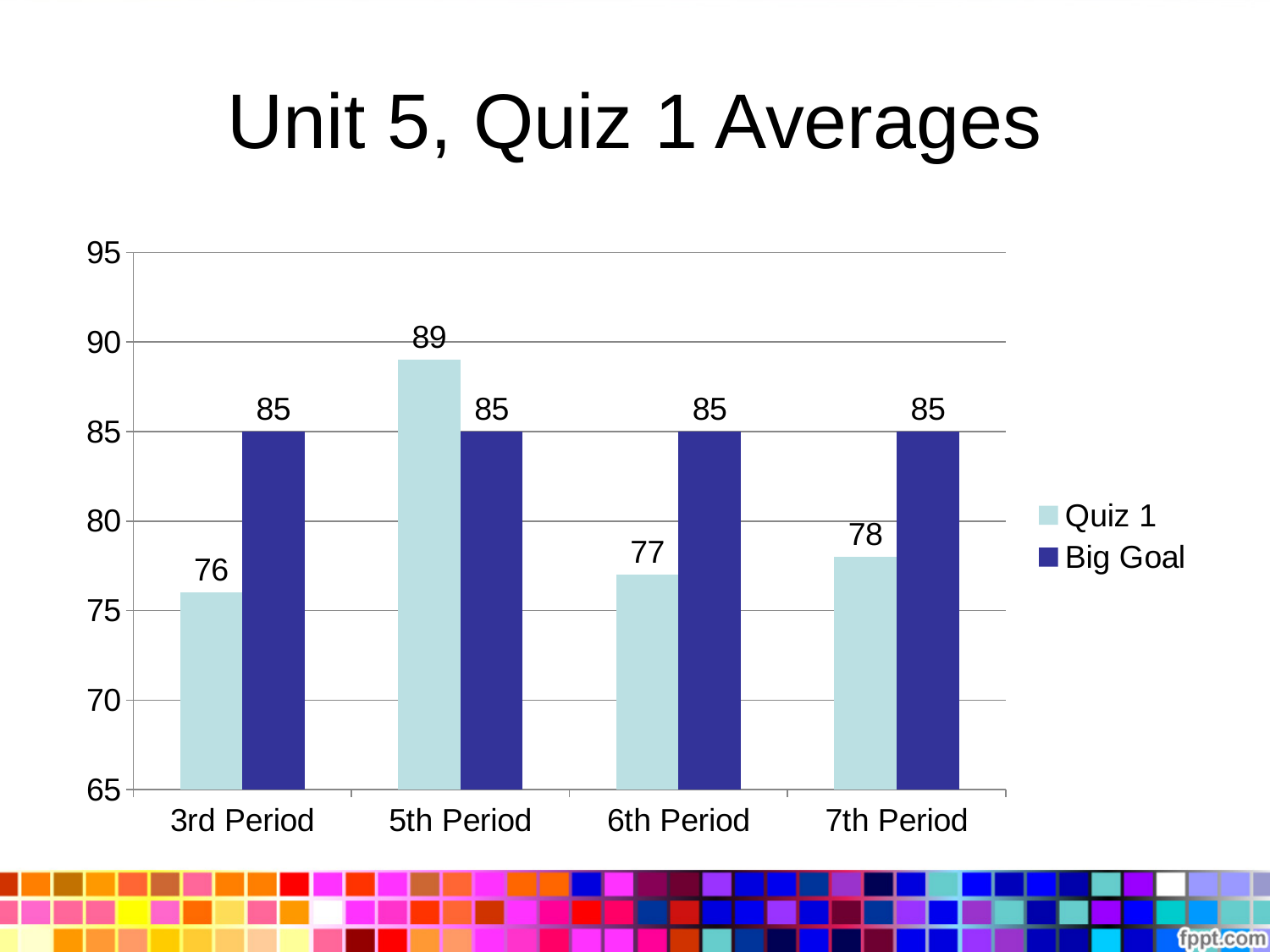
Which is larger for 6th Period, the Quiz 1 average or the Big Goal? Big Goal What is the Quiz 1 average for 5th Period? 89 How many series does the legend list? 2 What kind of chart is shown on the slide? Bar chart What is the difference between the Quiz 1 average for 5th Period and the Big Goal? 4 How many periods are shown on the x axis? 4 What is the Quiz 1 average for 3rd Period? 76 What is the Big Goal value for 6th Period? 85 How far below the Big Goal is the Quiz 1 average for 7th Period? 7 Which period has the highest Quiz 1 average? 5th Period What is the title of the chart? Unit 5, Quiz 1 Averages Which period has the lowest Quiz 1 average? 3rd Period